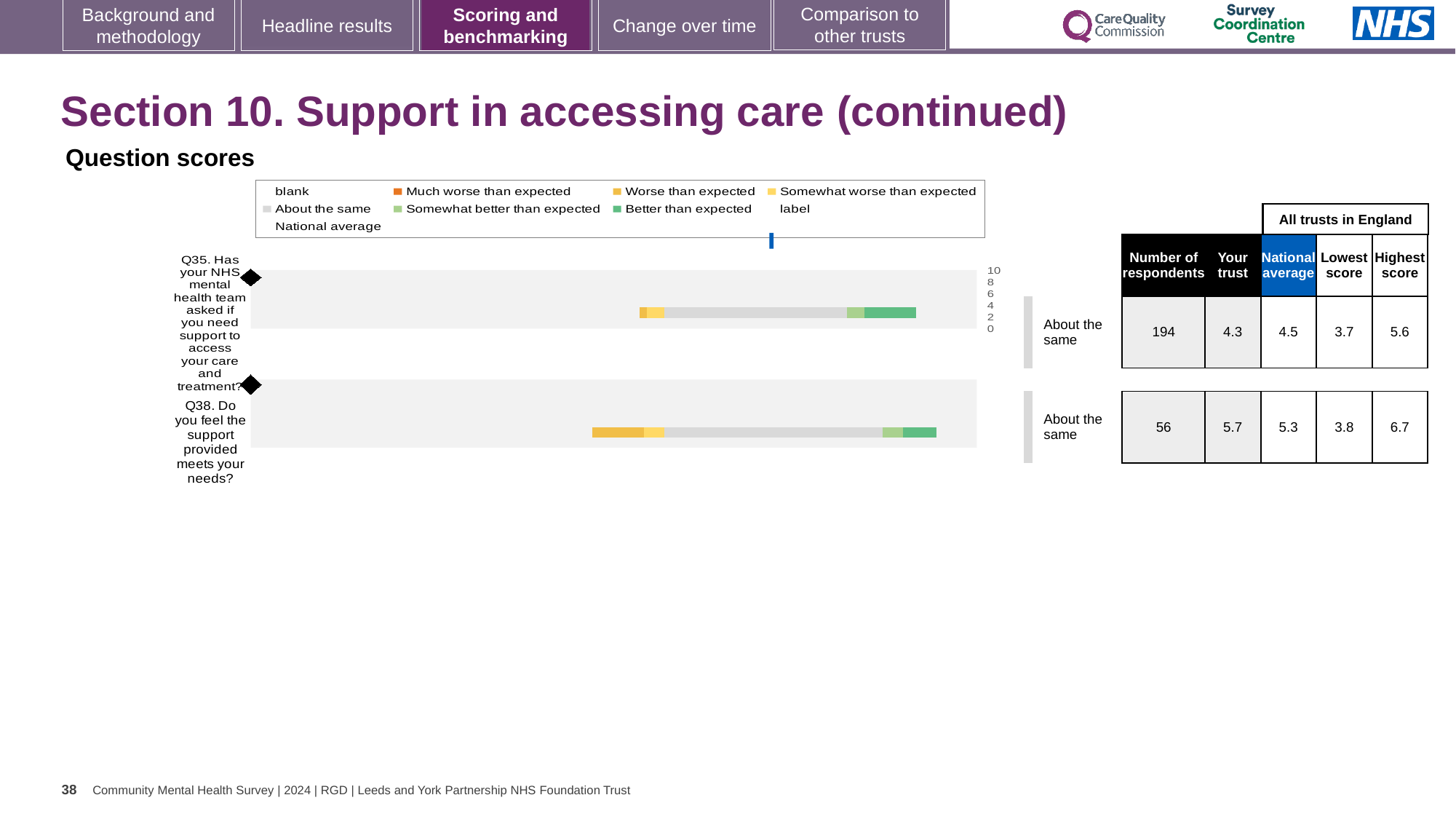
What is the national average score for Q38 (Do you feel the support provided meets your needs?)? 5.3 How many questions are plotted in the question scores chart? 2 What is the difference between the highest and lowest scores for Q38? 2.9 What is the lowest score among all trusts in England for Q35? 3.7 How many respondents answered Q35? 194 What is the highest score among all trusts in England for Q38? 6.7 What is the title shown above the chart? Question scores What kind of chart is used to show the question scores? bar chart How is the trust's result for Q38 categorised relative to expectations? About the same What is the 'Your trust' score for Q35 (Has your NHS mental health team asked if you need support to access your care and treatment?)? 4.3 What is the difference between the national average and the 'Your trust' score for Q35? 0.2 Which question has the higher 'Your trust' score, Q35 or Q38? Q38